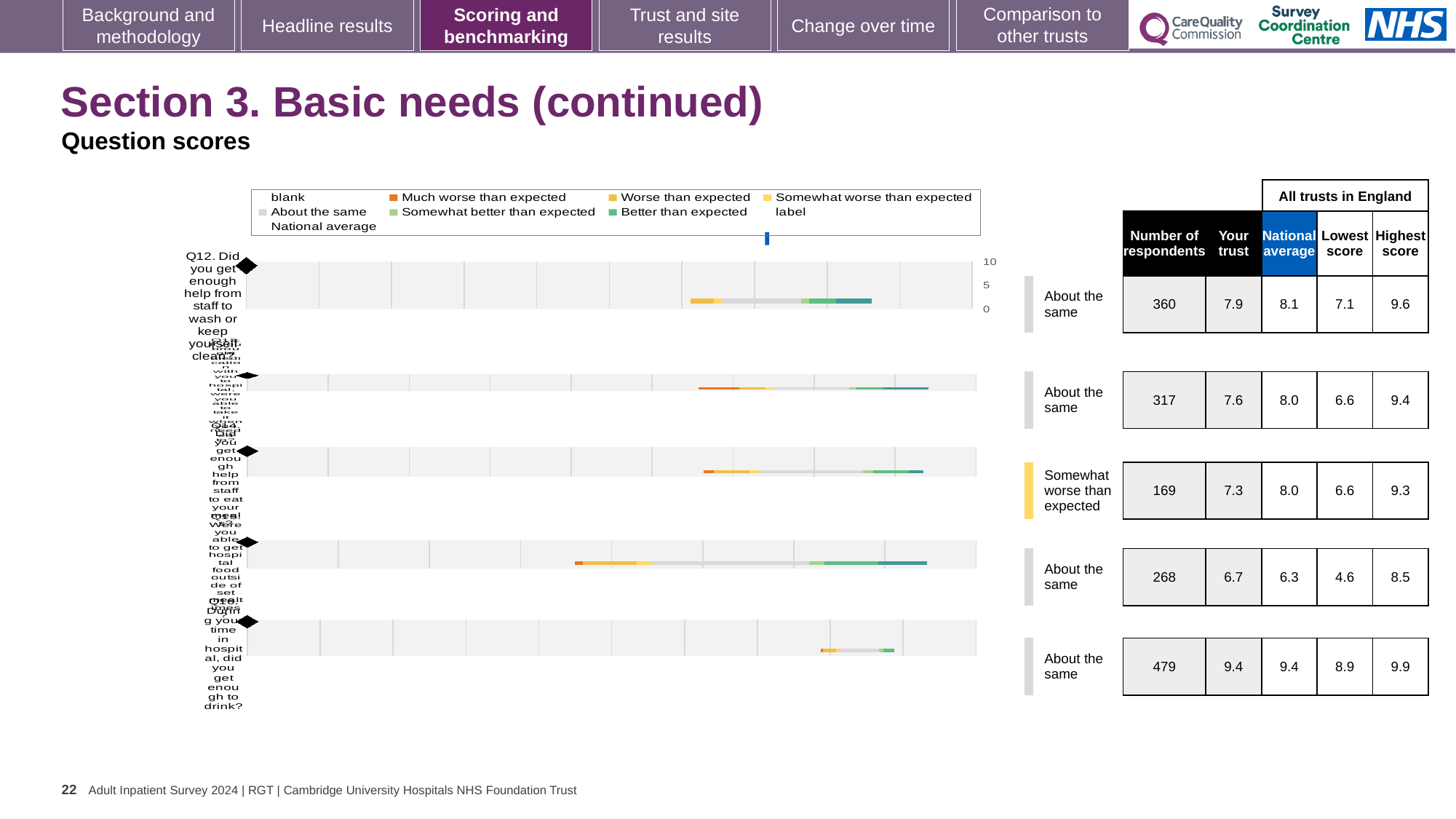
Which row is rated 'Somewhat worse than expected'? the third row (169 respondents) How many respondents answered Q12? 360 What kind of chart is shown on the slide? bar chart What colour represents 'Much worse than expected' in the legend? orange What is the lowest 'Your trust' score shown in the table? 6.7 How many question rows (bars) are plotted in the chart? 5 For Q12, which is larger: the 'Your trust' score or the national average? national average What is the highest 'Your trust' score shown in the table? 9.4 What is the national average score for Q12? 8.1 For Q12, what is the difference between the national average and the 'Your trust' score? 0.2 What is the 'Your trust' score for Q12 (Did you get enough help from staff to wash or keep yourself clean?)? 7.9 What is the lowest score among all trusts in England for Q12? 7.1